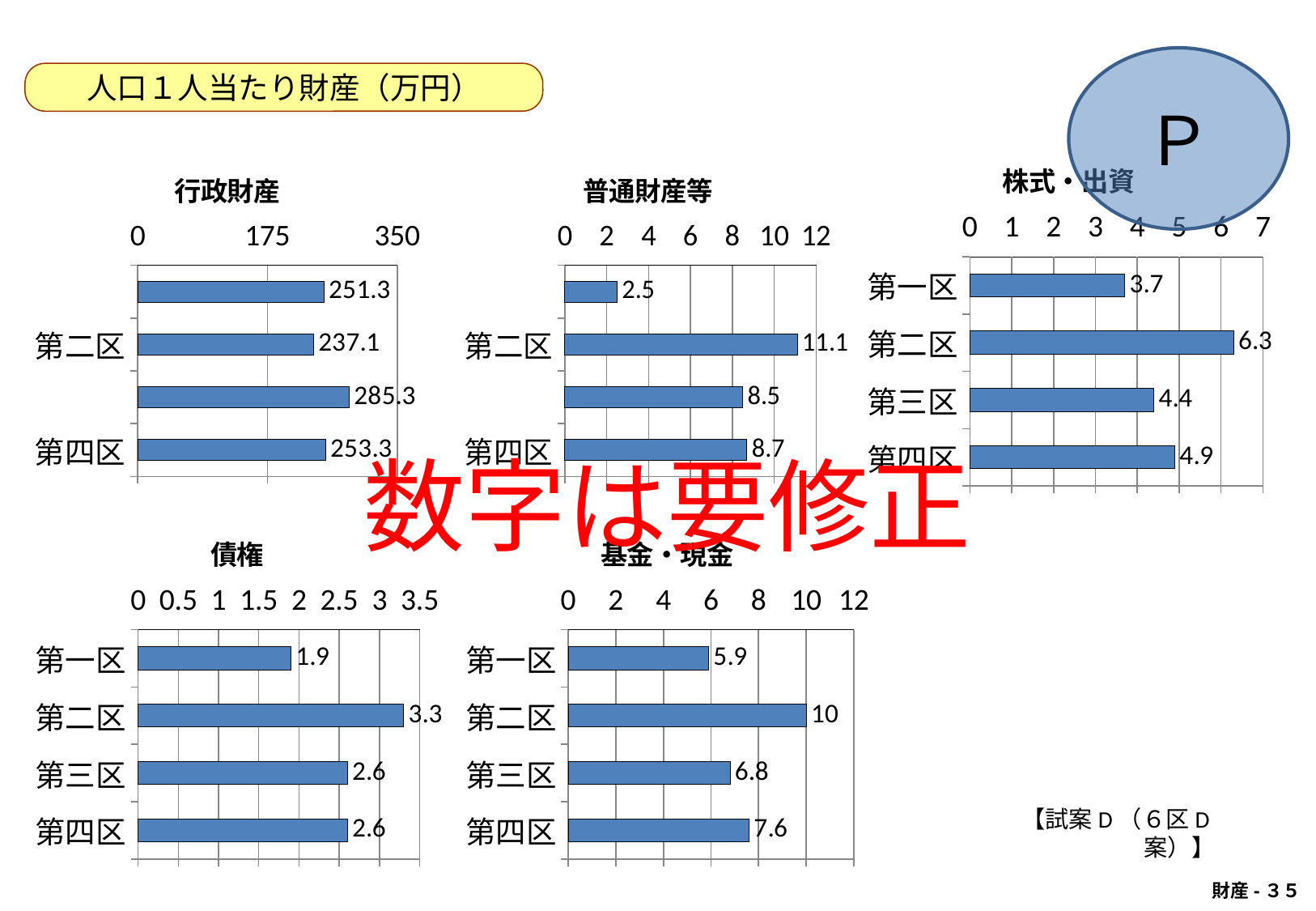
In the 債権 chart, which is larger, the value for 第一区 or 第三区? 第三区 What kind of chart is the 債権 chart? bar chart In the 基金・現金 chart, how many districts are plotted? 4 In the 株式・出資 chart, which district has the lowest value? 第一区 In the 株式・出資 chart, which district has the highest value? 第二区 In the 行政財産 chart, what is the value for 第四区? 253.3 In the 行政財産 chart, what is the value for 第二区? 237.1 In the 株式・出資 chart, what is the value for 第三区? 4.4 In the 普通財産等 chart, what is the difference between the values for 第二区 and 第四区? 2.4 In the 債権 chart, what is the value for 第二区? 3.3 In the 普通財産等 chart, what is the value for 第二区? 11.1 In the 基金・現金 chart, what is the value for 第四区? 7.6